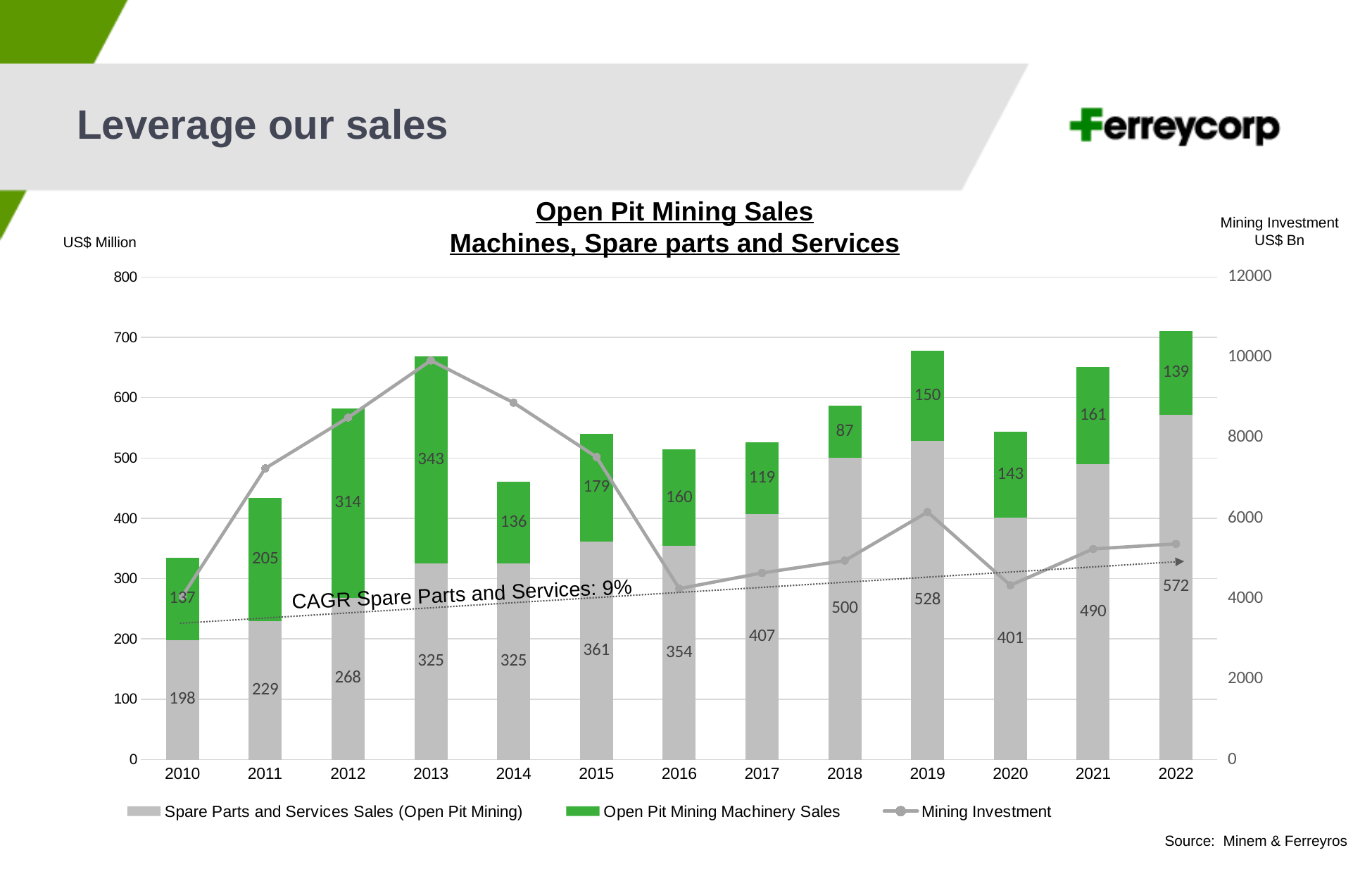
What CAGR for Spare Parts and Services is annotated on the chart? 9% What is the total of the stacked bar for 2022? 711 In which year is Open Pit Mining Machinery Sales lowest? 2018 What is the Open Pit Mining Machinery Sales value for 2013? 343 Which year has higher Open Pit Mining Machinery Sales, 2011 or 2015? 2011 What is the difference between Spare Parts and Services Sales in 2022 and 2021? 82 Is the Mining Investment value for 2013 greater or less than 8000? greater How many years are shown on the x axis? 13 What is the Spare Parts and Services Sales value for 2018? 500 How many series does the legend list? 3 In which year is Open Pit Mining Machinery Sales highest? 2013 In which year is Spare Parts and Services Sales highest? 2022